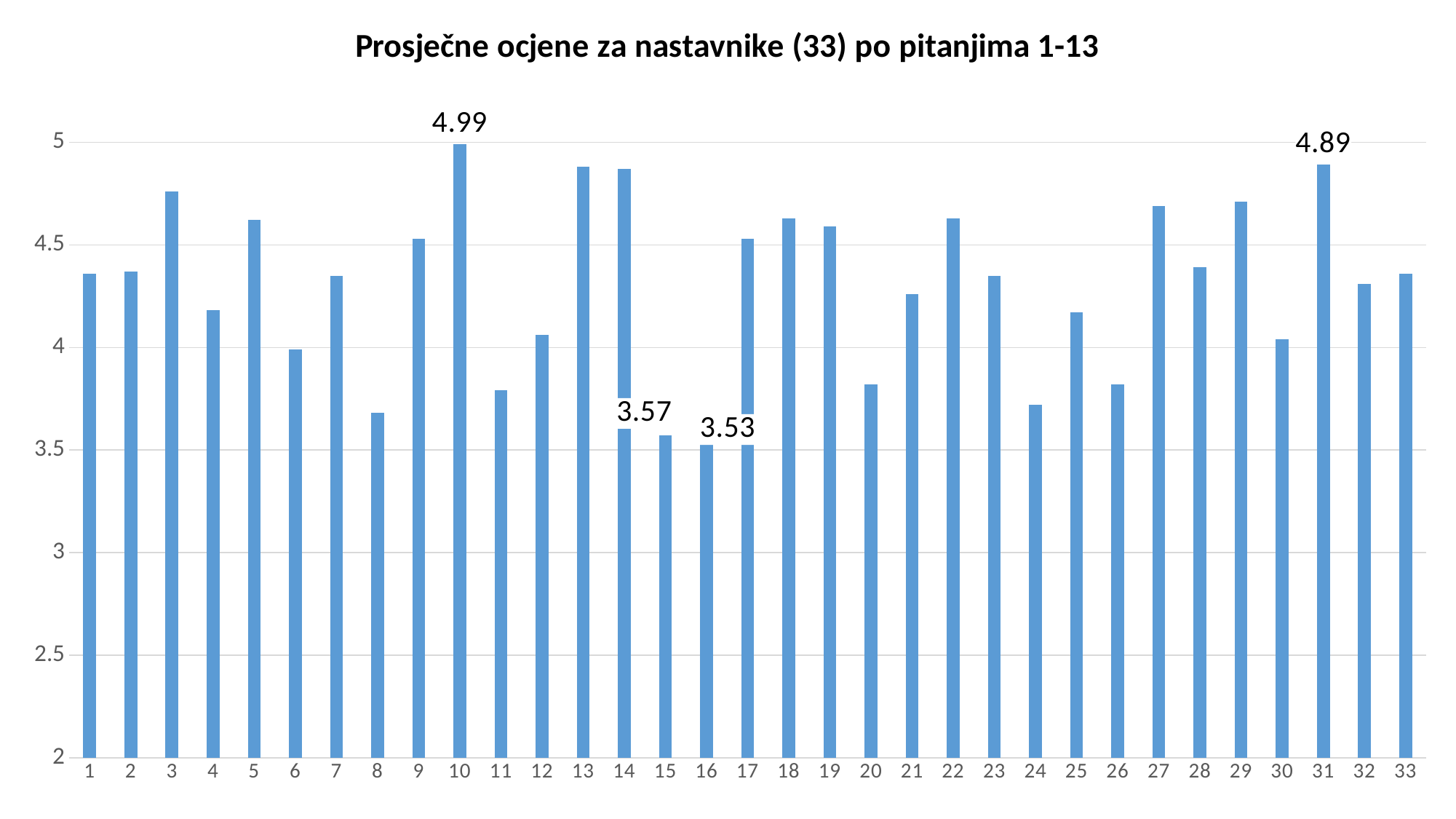
Which is larger, the value for category 3 or the value for category 4? 3 What is the value for category 16? 3.53 Which category has the lowest value? 16 What is the value for category 10? 4.99 Is the value for category 27 greater or less than 4.5? greater What is the difference between the values for category 10 and category 31? 0.10 What type of chart is shown on the slide? bar chart How many categories are shown on the x axis? 33 Which category has the highest value? 10 Is the value for category 8 greater or less than 4? less What is the value for category 31? 4.89 What is the difference between the values for category 10 and category 16? 1.46